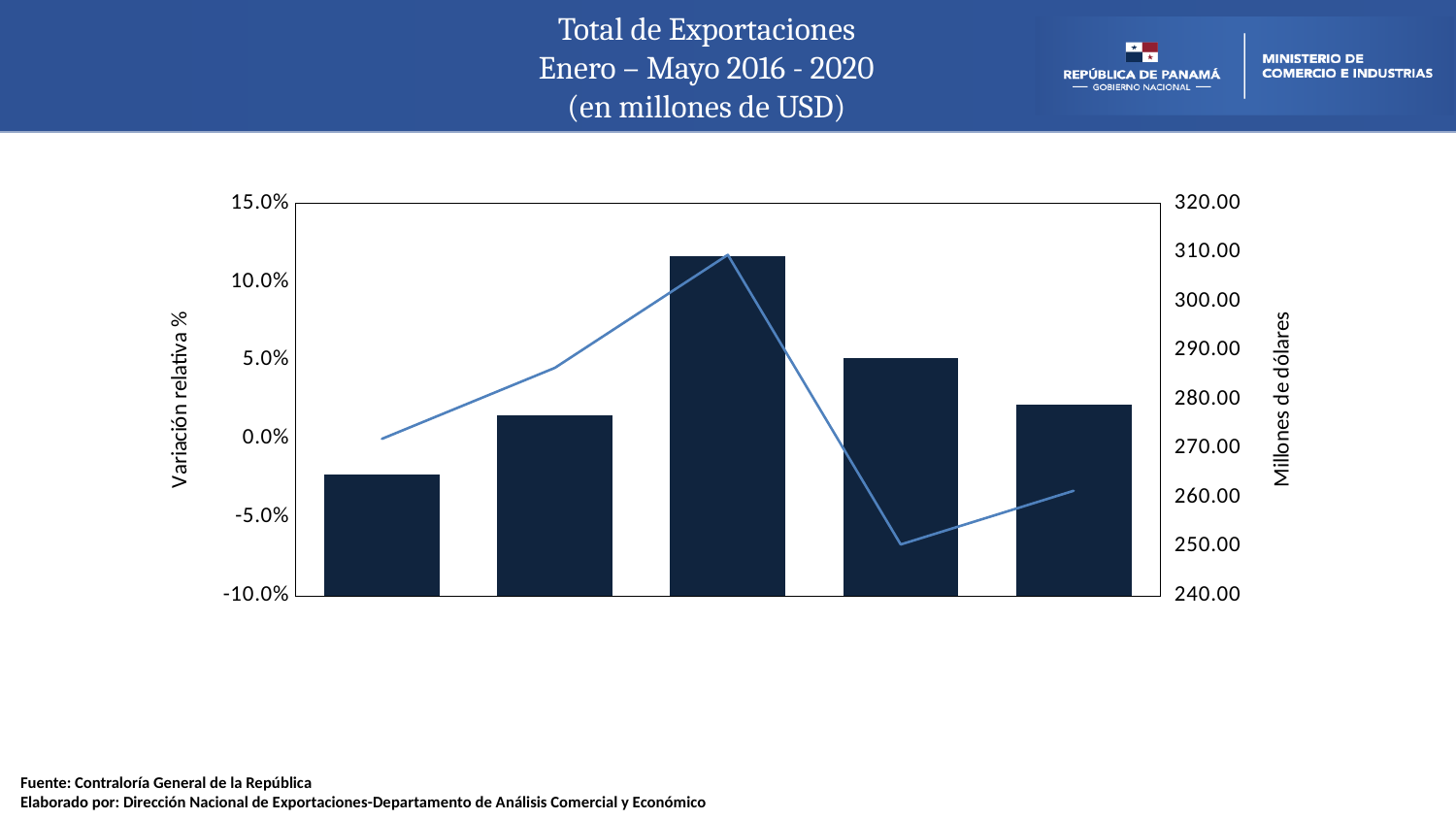
What is the maximum value shown on the right vertical axis? 320.00 Which bar is the shortest in the chart? The first bar What is the title of the right vertical axis? Millones de dólares Which is taller, the second bar or the fourth bar? The fourth bar What kind of chart is shown on the slide? A bar chart combined with a line Does the line rise or fall from the first point to the third point? Rise Which is taller, the first bar or the fifth bar? The fifth bar What is the title of the left vertical axis? Variación relativa % Which bar is the tallest in the chart? The third bar Does the line rise or fall between the third and fourth points? Fall How many bars are plotted in the chart? 5 What is the minimum value shown on the left vertical axis? -10.0%